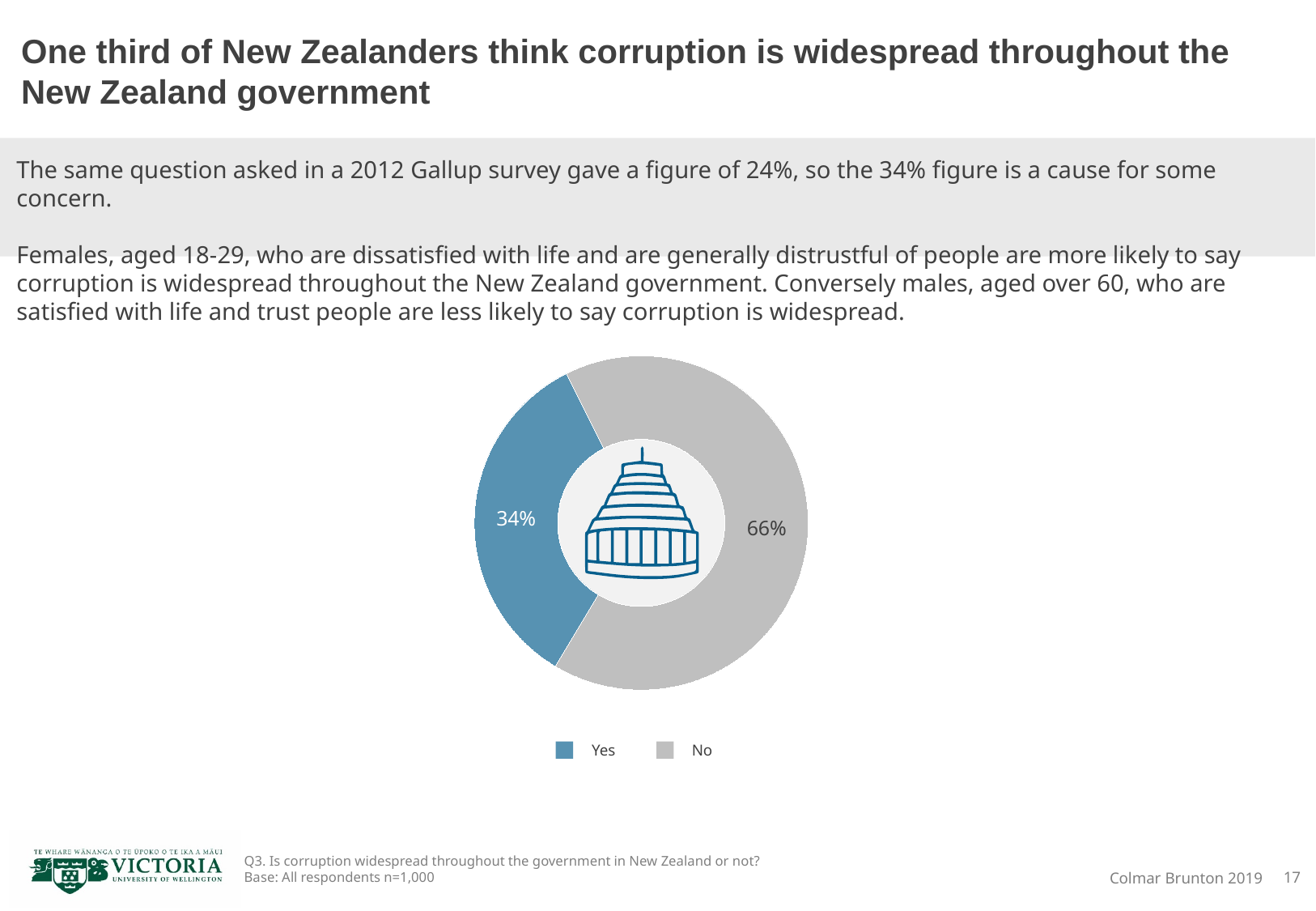
What percentage of respondents answered Yes? 34% What is the difference in percentage points between the No and Yes shares? 32 What is the total of the Yes and No shares? 100% What share of the pie does the Yes slice represent? 34% What percentage of respondents answered No? 66% What are the two legend entries for the chart? Yes and No What kind of chart is shown on the slide? doughnut chart Is the share for Yes larger or smaller than the share for No? smaller Which response has the larger share of the pie? No Which response has the smaller share of the pie? Yes What colour is the Yes slice in the chart? blue How many categories does the chart show? 2